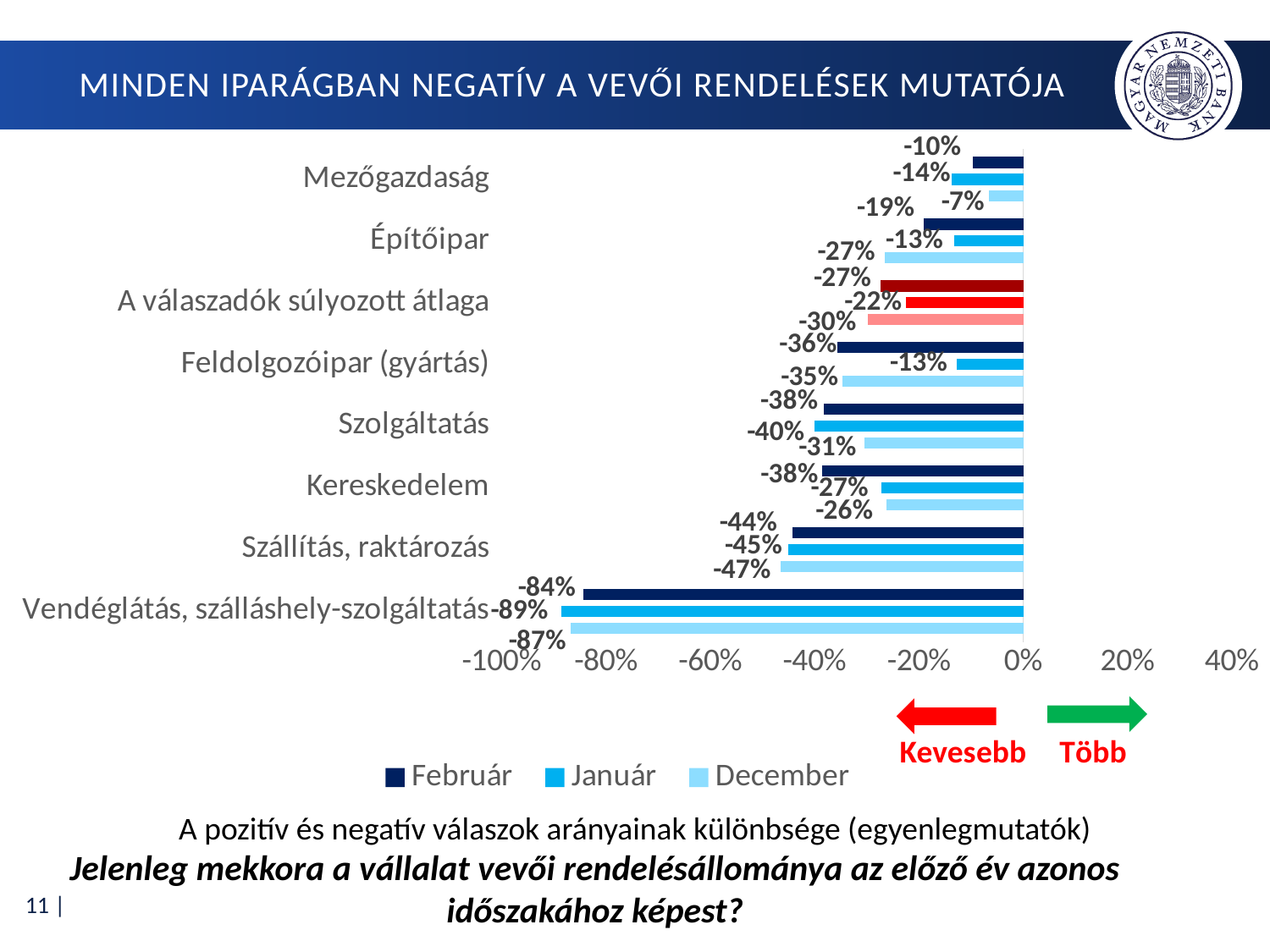
Which series is shown in the darkest blue colour? Február What is the December value for Építőipar? -27% Which category has the highest December value? Mezőgazdaság Which is larger, the Február value for Szolgáltatás or the Február value for Szállítás, raktározás? Szolgáltatás Which category has the lowest Január value? Vendéglátás, szálláshely-szolgáltatás How many categories are shown on the chart? 8 What is the Január value for Feldolgozóipar (gyártás)? -13% What kind of chart is shown on the slide? Bar chart How many series does the legend list? 3 What is the Február value for Mezőgazdaság? -10% What is the difference between the Február and Január values for Feldolgozóipar (gyártás)? 23 percentage points What is the Február value for Vendéglátás, szálláshely-szolgáltatás? -84%